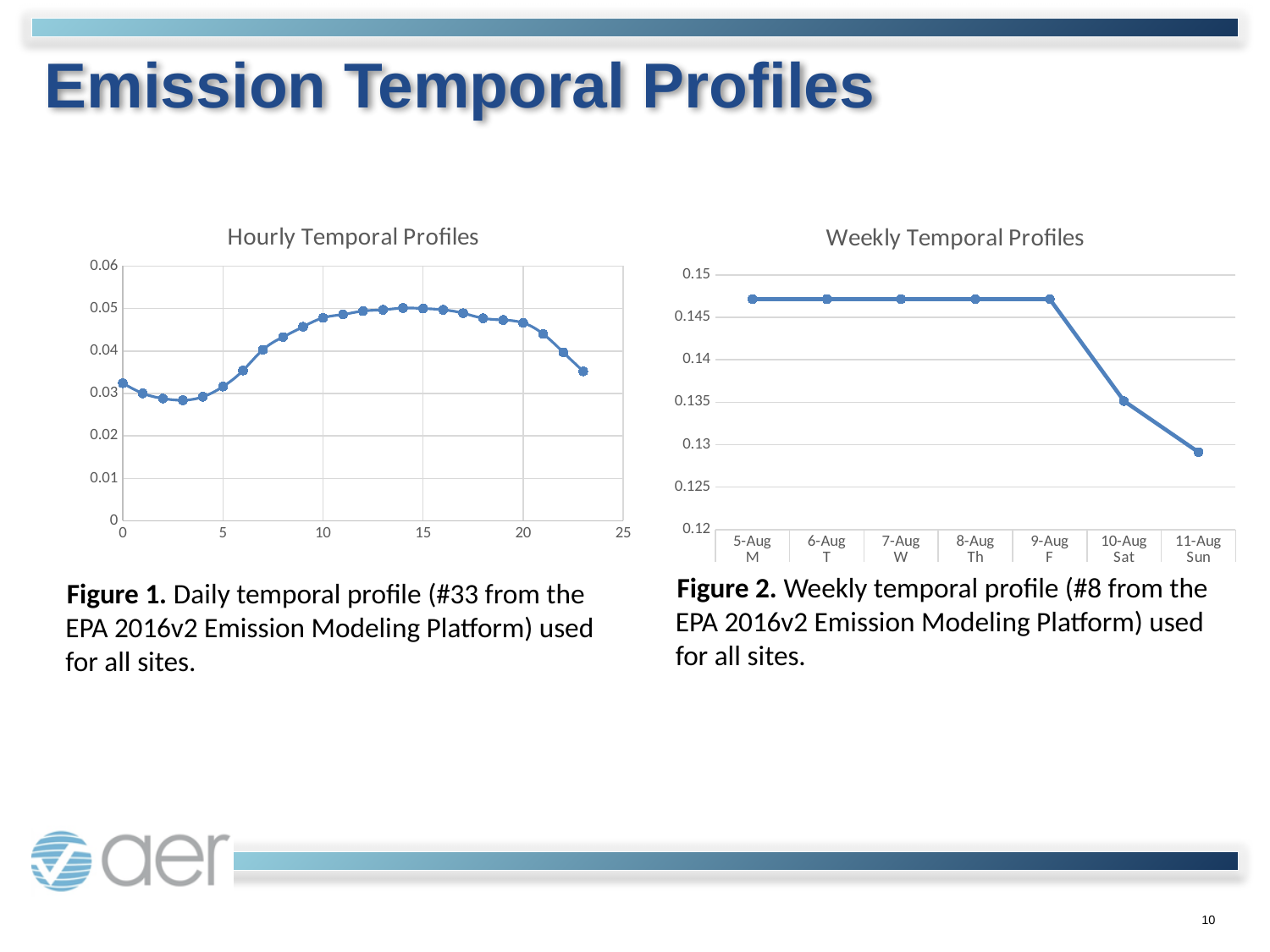
What type of chart is the Weekly Temporal Profiles chart? line chart In the Hourly Temporal Profiles chart, do the values rise or fall from hour 5 to hour 12? rise In the Hourly Temporal Profiles chart, is the value at hour 3 greater or less than 0.03? less How many categories are shown on the x axis of the Weekly Temporal Profiles chart? 7 What is the title of the chart on the left side of the slide? Hourly Temporal Profiles In the Hourly Temporal Profiles chart, is the value at hour 0 greater or less than 0.03? greater In the Weekly Temporal Profiles chart, which is larger, the value for 10-Aug Sat or the value for 11-Aug Sun? 10-Aug Sat In the Weekly Temporal Profiles chart, do the values rise or fall from 9-Aug F to 11-Aug Sun? fall In the Weekly Temporal Profiles chart, which day has the lowest value? 11-Aug Sun In the Weekly Temporal Profiles chart, is the value for 11-Aug Sun greater or less than 0.13? less In the Hourly Temporal Profiles chart, which is larger, the value at hour 0 or the value at hour 10? hour 10